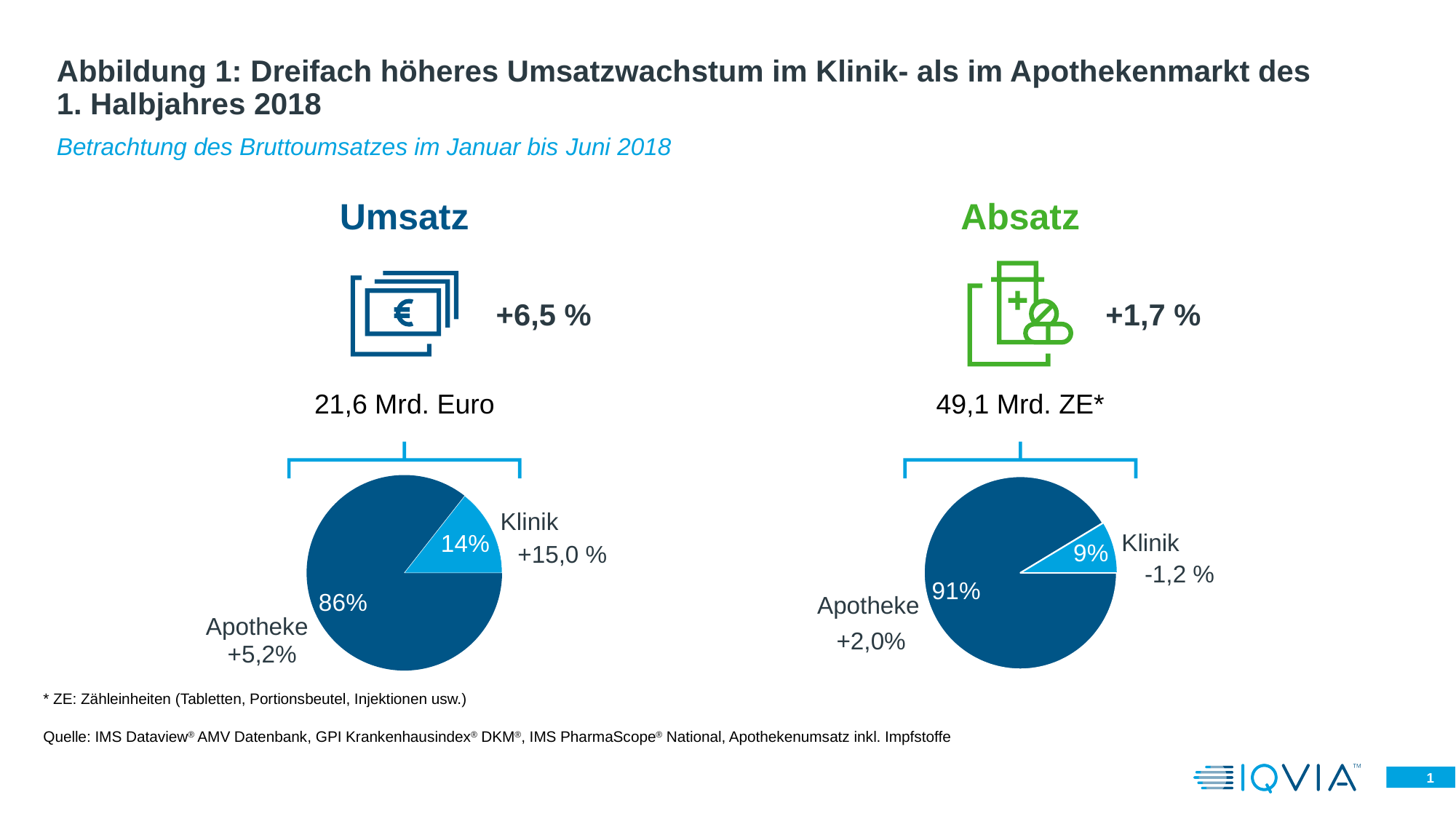
In the Umsatz pie chart, what is the difference in percentage points between the Apotheke and Klinik shares? 72 In the Absatz pie chart, what share does Klinik have? 9% In the Absatz pie chart, which segment is the smallest? Klinik Is the Klinik share larger in the Umsatz pie chart or in the Absatz pie chart? Umsatz In the Umsatz pie chart, which segment is the largest? Apotheke In the Absatz pie chart, what is the difference in percentage points between the Apotheke and Klinik shares? 82 What type of chart is used for Umsatz and Absatz on this slide? Pie chart In the Absatz pie chart, what share does Apotheke have? 91% How many segments does the Umsatz pie chart have? 2 In the Umsatz pie chart, what share does Apotheke have? 86% In the Umsatz pie chart, what share does Klinik have? 14% What growth rate is shown next to the Klinik segment in the Absatz pie chart? -1,2 %